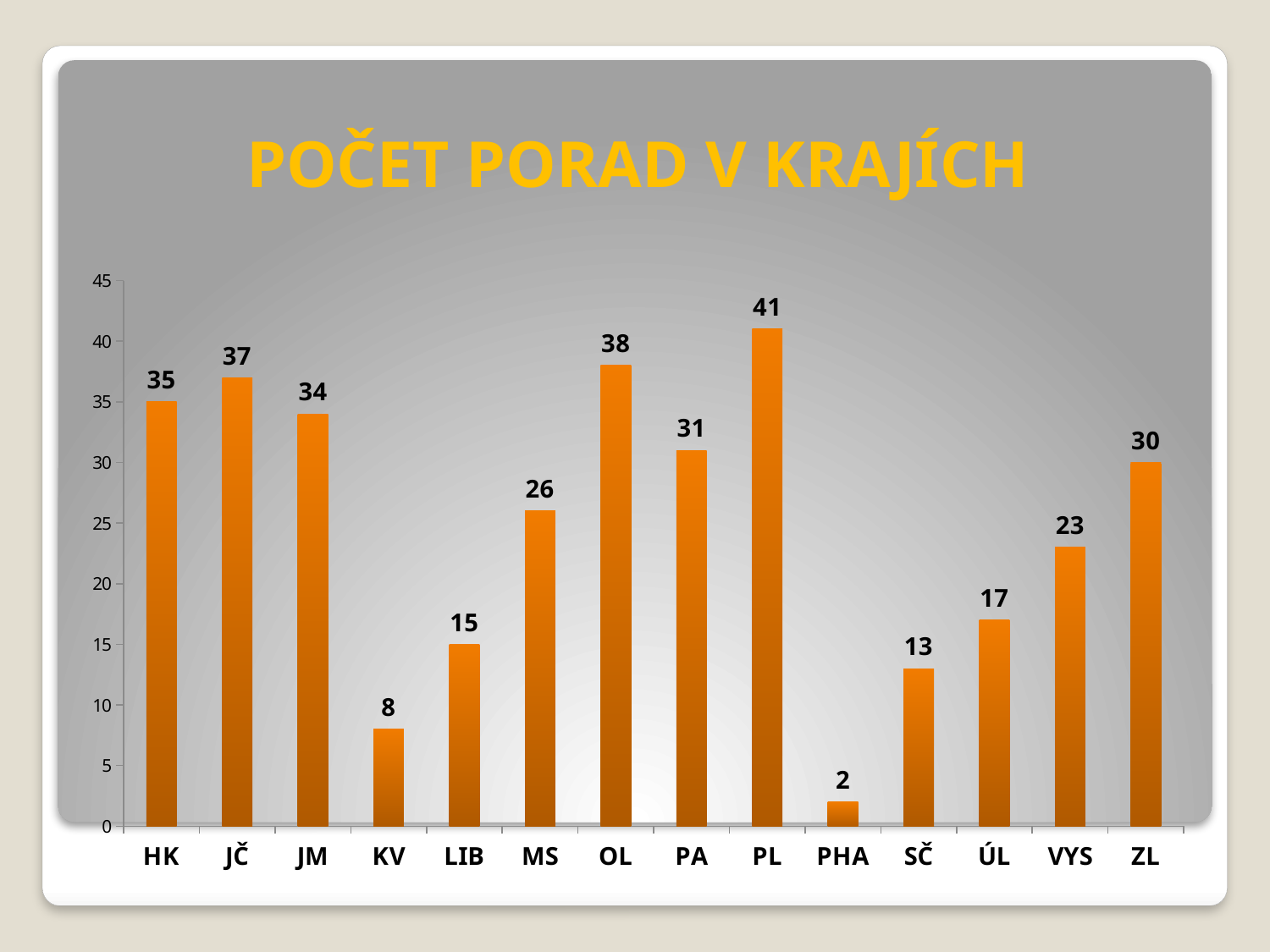
What is the value for MS? 26 What is the value for PHA? 2 Which category has the highest value? PL Which category has the lowest value? PHA What is the title of the chart? POČET PORAD V KRAJÍCH What is the difference between the values for HK and KV? 27 How many categories are shown on the x axis? 14 Which is larger, the value for JČ or the value for JM? JČ Is the value for VYS greater or less than 20? greater What is the difference between the values for PL and OL? 3 What kind of chart is shown on the slide? bar chart What is the value for PL? 41